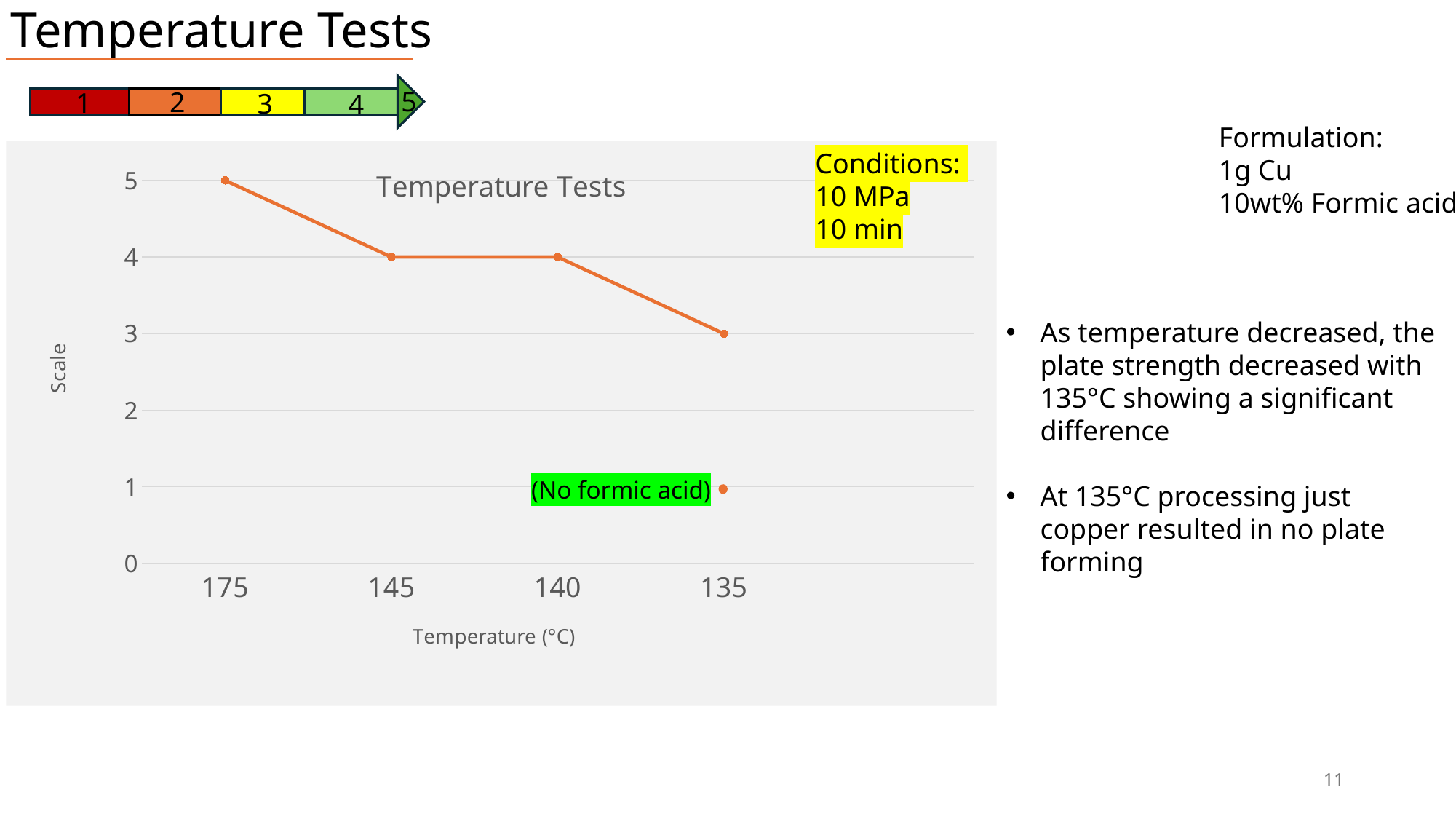
How many temperature categories are shown on the x axis? 4 Does the Scale value rise or fall along the x axis from 175 to 135? fall What is the Scale value at 145 °C? 4 What is the Scale value at 175 °C? 5 Which has a higher Scale value on the line, 145 °C or 135 °C? 145 °C At which temperature does the line reach its highest Scale value? 175 What is the Scale value at 140 °C? 4 What type of chart is shown on the slide? line chart What is the difference in Scale between 175 °C and 135 °C on the main line? 2 What Scale value is shown for the point labelled "(No formic acid)"? 1 What is the Scale value at 135 °C on the main line? 3 What is the title of the chart? Temperature Tests